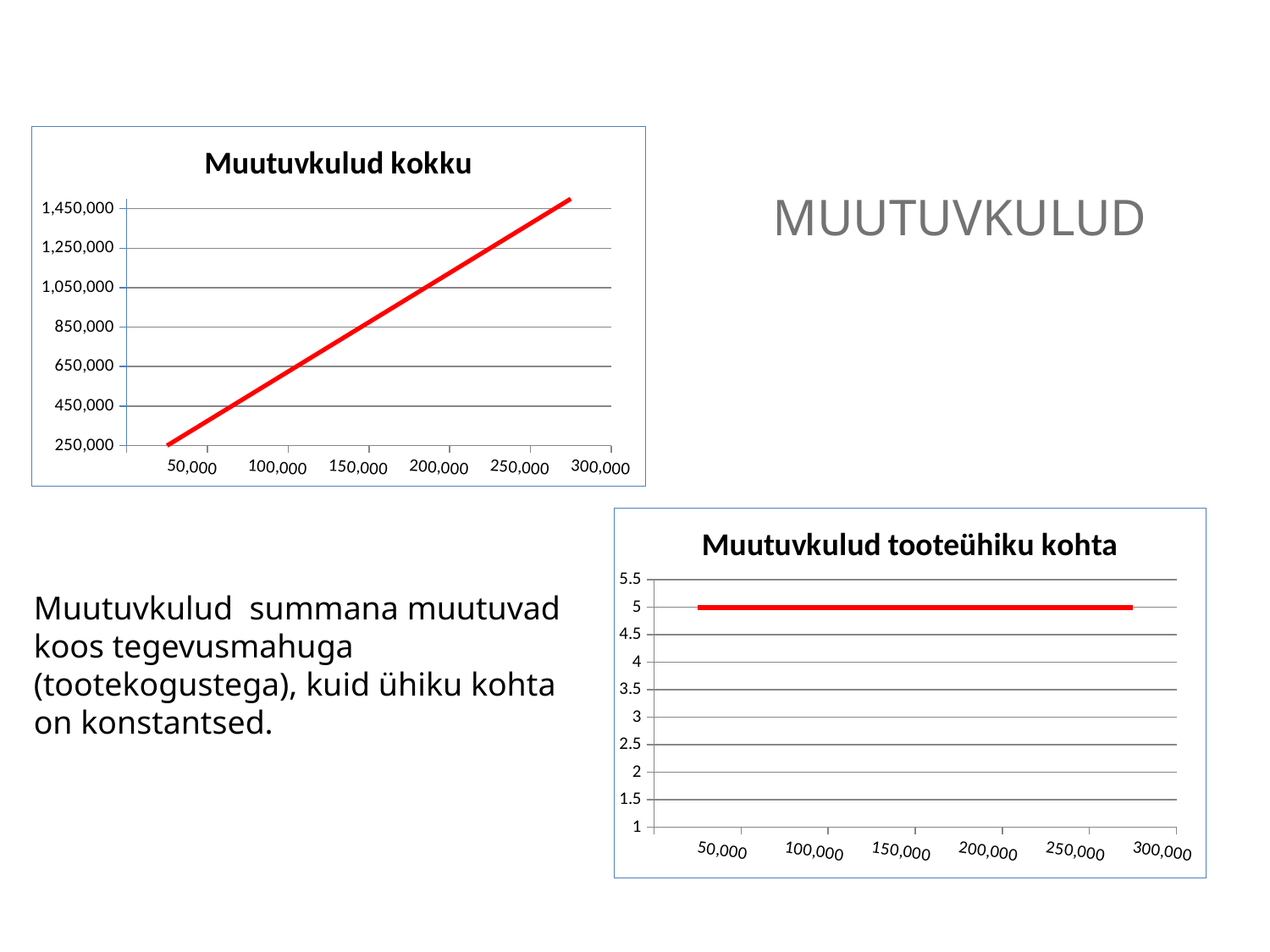
How many tick labels are shown on the x axis of the 'Muutuvkulud kokku' chart? 6 In the 'Muutuvkulud tooteühiku kohta' chart, what is the value at 150,000? 5 In the 'Muutuvkulud tooteühiku kohta' chart, do the values rise, fall or stay constant along the x axis? stay constant In the 'Muutuvkulud kokku' chart, is the value at 200,000 greater or less than 850,000? greater In the 'Muutuvkulud kokku' chart, is the value at 100,000 greater or less than 650,000? less In the 'Muutuvkulud kokku' chart, what is the value at 50,000? 250,000 In the 'Muutuvkulud tooteühiku kohta' chart, is the value at 250,000 greater or less than 4? greater What kind of chart is the 'Muutuvkulud tooteühiku kohta' chart? line chart In the 'Muutuvkulud kokku' chart, what is the value at 250,000? 1,250,000 What is the title of the chart in the lower right of the slide? Muutuvkulud tooteühiku kohta What kind of chart is the 'Muutuvkulud kokku' chart? line chart In the 'Muutuvkulud kokku' chart, do the values rise or fall as the x axis increases? rise